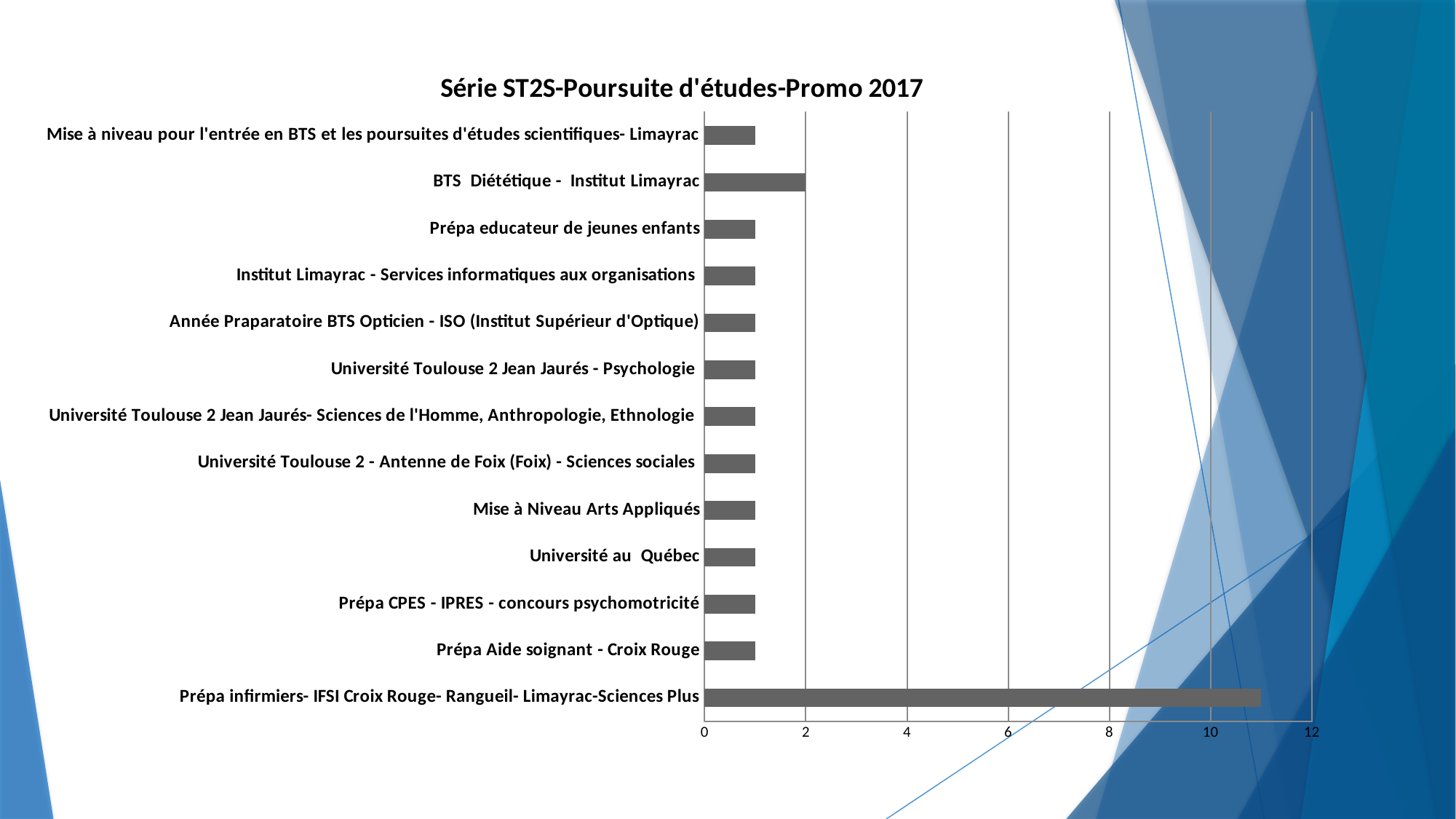
How many categories are plotted in the chart? 13 What kind of chart is shown on the slide? bar chart Is the value for Université au Québec greater or less than 2? less Is the value for Prépa infirmiers- IFSI Croix Rouge- Rangueil- Limayrac-Sciences Plus greater or less than 12? less Is the value for Prépa infirmiers- IFSI Croix Rouge- Rangueil- Limayrac-Sciences Plus greater or less than 10? greater What is the highest value shown on the horizontal axis? 12 What is the value for BTS Diététique - Institut Limayrac? 2 Which is larger, the value for Prépa infirmiers- IFSI Croix Rouge- Rangueil- Limayrac-Sciences Plus or the value for BTS Diététique - Institut Limayrac? Prépa infirmiers- IFSI Croix Rouge- Rangueil- Limayrac-Sciences Plus Which is larger, the value for BTS Diététique - Institut Limayrac or the value for Mise à Niveau Arts Appliqués? BTS Diététique - Institut Limayrac What is the title of the chart? Série ST2S-Poursuite d'études-Promo 2017 Which category has the highest value? Prépa infirmiers- IFSI Croix Rouge- Rangueil- Limayrac-Sciences Plus